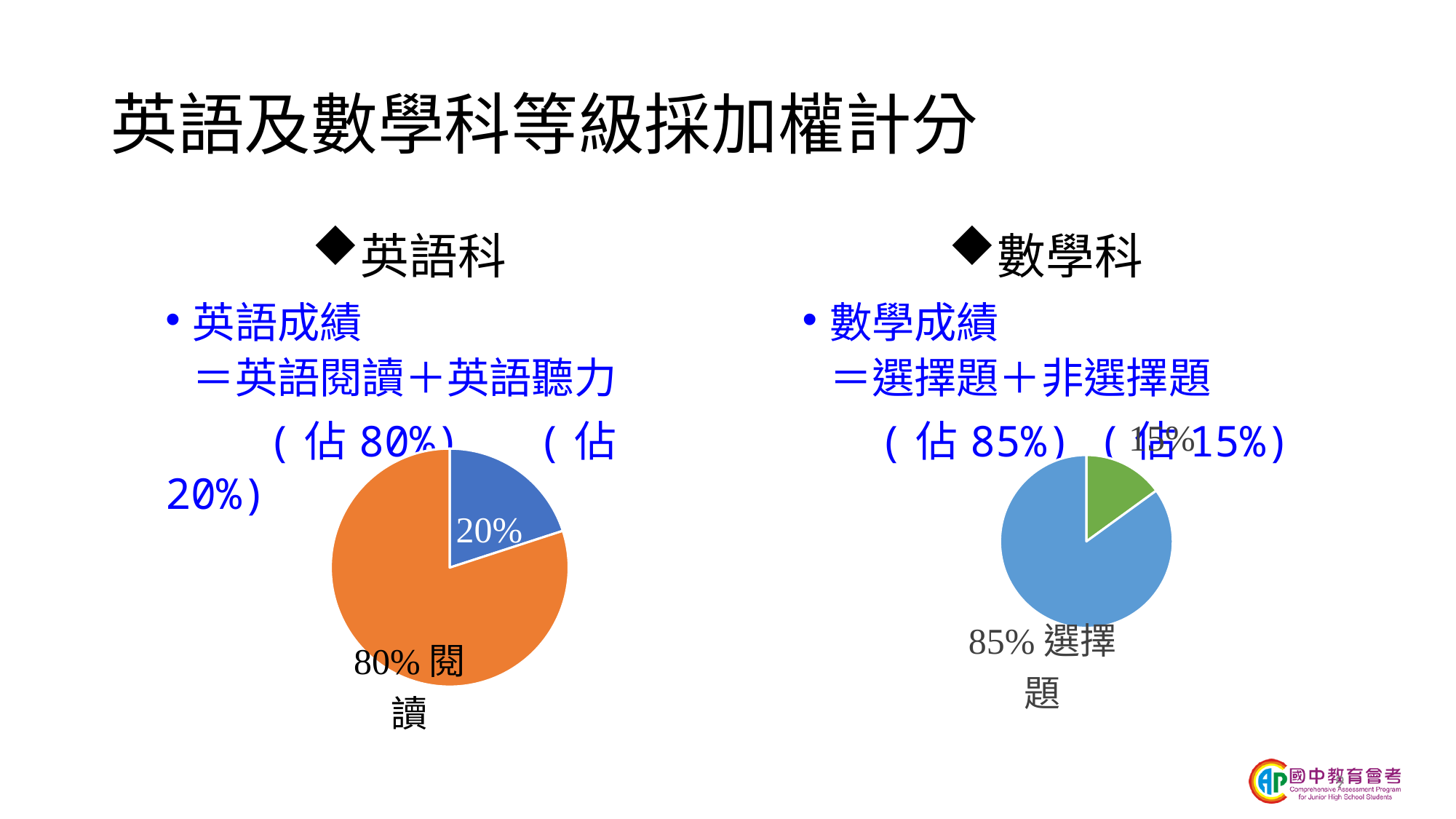
In the right pie chart (數學科), what is the difference between the 85% slice and the 15% slice? 70% In the left pie chart (英語科), what is the difference between the 80% slice and the 20% slice? 60% In the left pie chart (英語科), which slice is the largest? 閱讀 What kind of chart is shown under the 英語科 heading on the left? pie chart In the left pie chart (英語科), what share does the blue slice have? 20% In the right pie chart (數學科), what share does the green slice have? 15% In the right pie chart (數學科), which slice is the largest? 選擇題 In the left pie chart (英語科), what share does the 閱讀 slice have? 80% How many slices does the right pie chart (數學科) have? 2 How many slices does the left pie chart (英語科) have? 2 What kind of chart is shown under the 數學科 heading on the right? pie chart